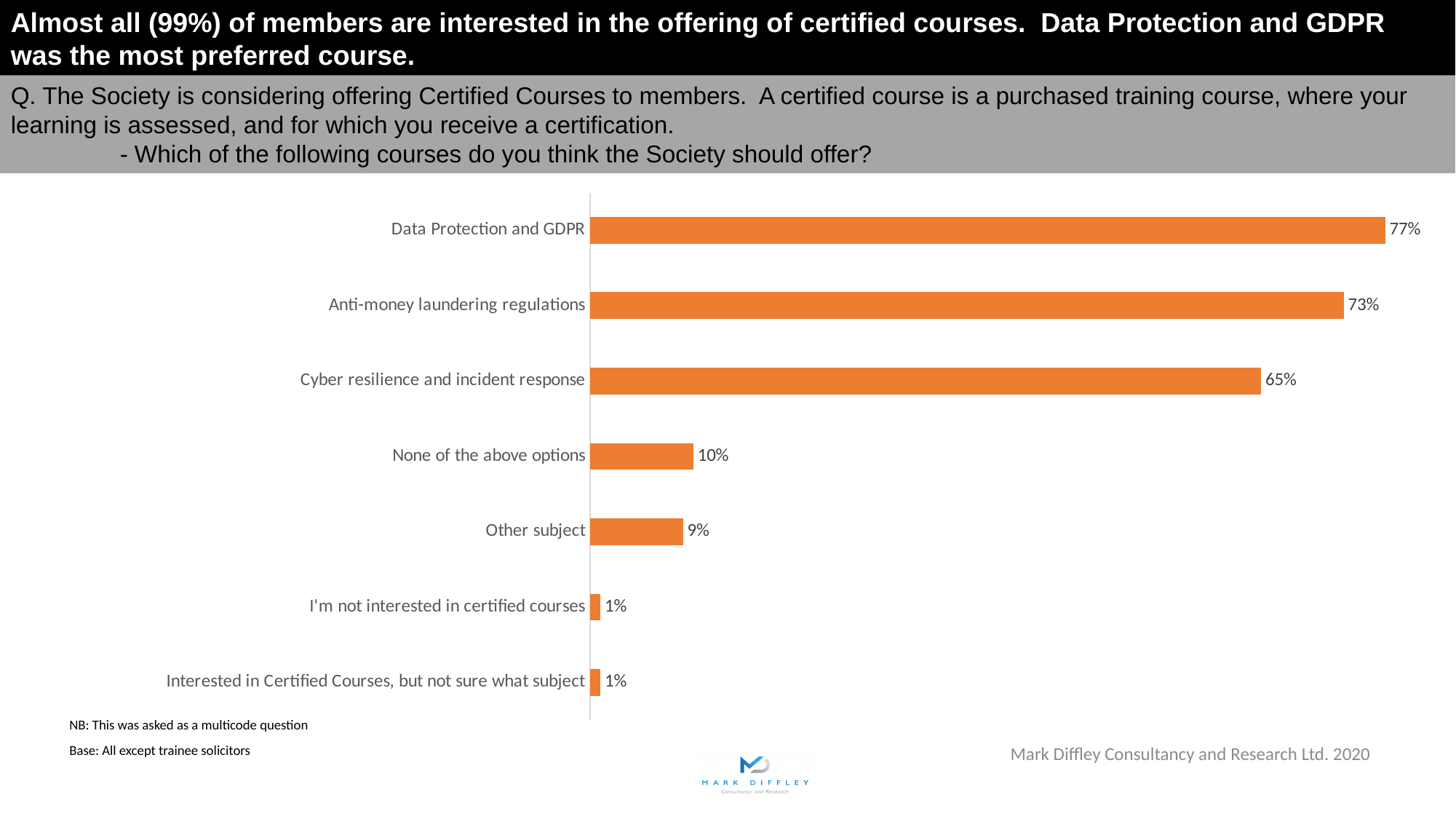
What is the difference between the values for Anti-money laundering regulations and Cyber resilience and incident response? 8% What percentage of members said they are not interested in certified courses? 1% What is the value for Cyber resilience and incident response? 65% What is the difference between the values for Data Protection and GDPR and Anti-money laundering regulations? 4% What is the value for 'Other subject'? 9% What percentage of members think the Society should offer a Data Protection and GDPR course? 77% Which course has the highest percentage? Data Protection and GDPR What is the value for Anti-money laundering regulations? 73% Which is larger: the value for 'None of the above options' or 'Other subject'? None of the above options What kind of chart is shown on the slide? Bar chart What percentage selected 'None of the above options'? 10% How many categories are shown in the chart? 7